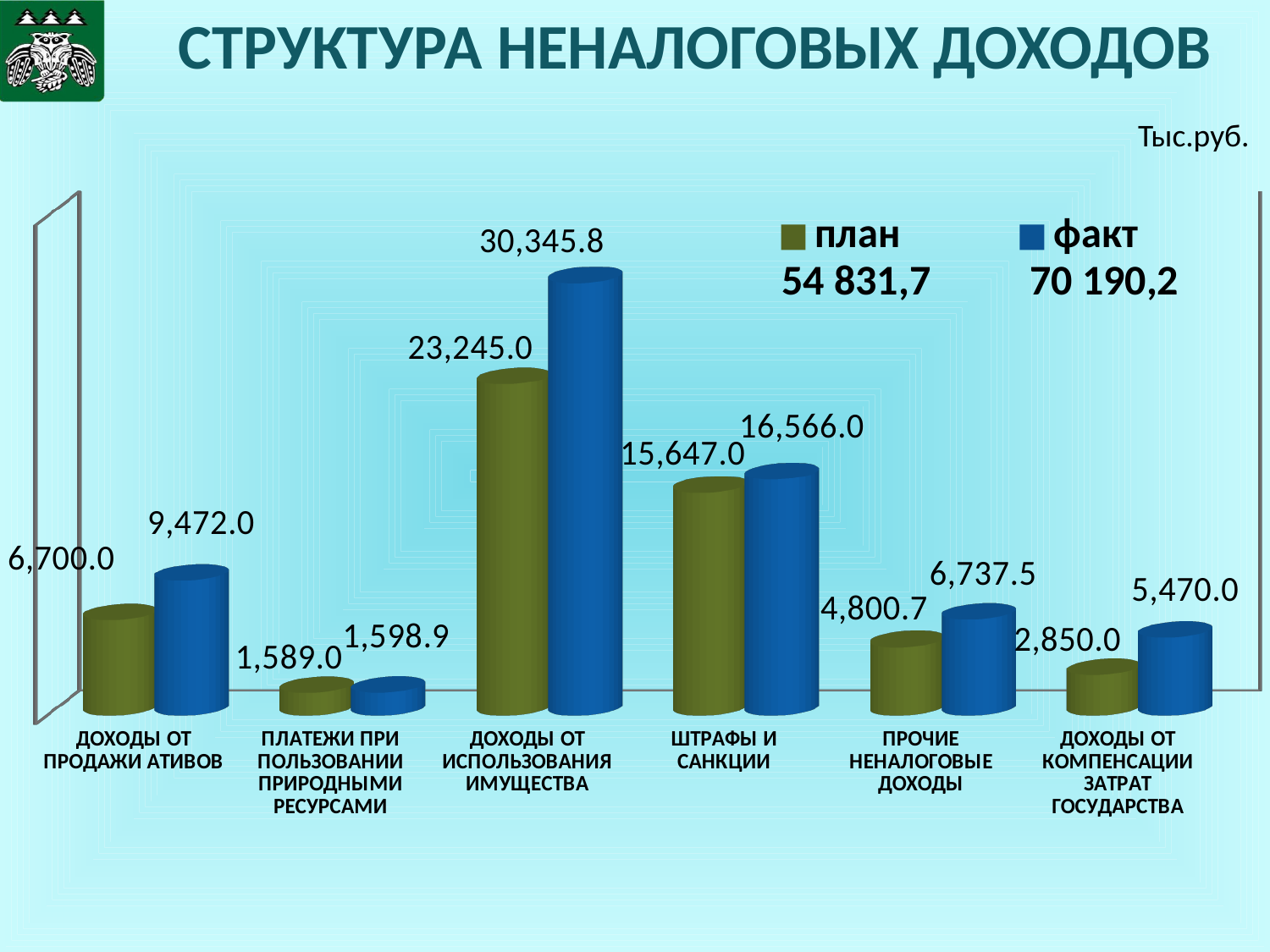
Which category has the lowest план value? ПЛАТЕЖИ ПРИ ПОЛЬЗОВАНИИ ПРИРОДНЫМИ РЕСУРСАМИ What is the план (plan) value for ДОХОДЫ ОТ ИСПОЛЬЗОВАНИЯ ИМУЩЕСТВА? 23,245.0 What is the факт value for ДОХОДЫ ОТ КОМПЕНСАЦИИ ЗАТРАТ ГОСУДАРСТВА? 5,470.0 What is the difference between the факт and план values for ДОХОДЫ ОТ ИСПОЛЬЗОВАНИЯ ИМУЩЕСТВА? 7,100.8 What is the план value for ПРОЧИЕ НЕНАЛОГОВЫЕ ДОХОДЫ? 4,800.7 What is the факт (actual) value for ШТРАФЫ И САНКЦИИ? 16,566.0 How many series does the legend list? 2 What is the difference between the факт and план values for ДОХОДЫ ОТ ПРОДАЖИ АТИВОВ? 2,772.0 What type of chart is shown on the slide? bar chart Which is larger for ШТРАФЫ И САНКЦИИ: the план value or the факт value? факт Which category has the highest факт value? ДОХОДЫ ОТ ИСПОЛЬЗОВАНИЯ ИМУЩЕСТВА How many categories are shown on the x axis of the chart? 6